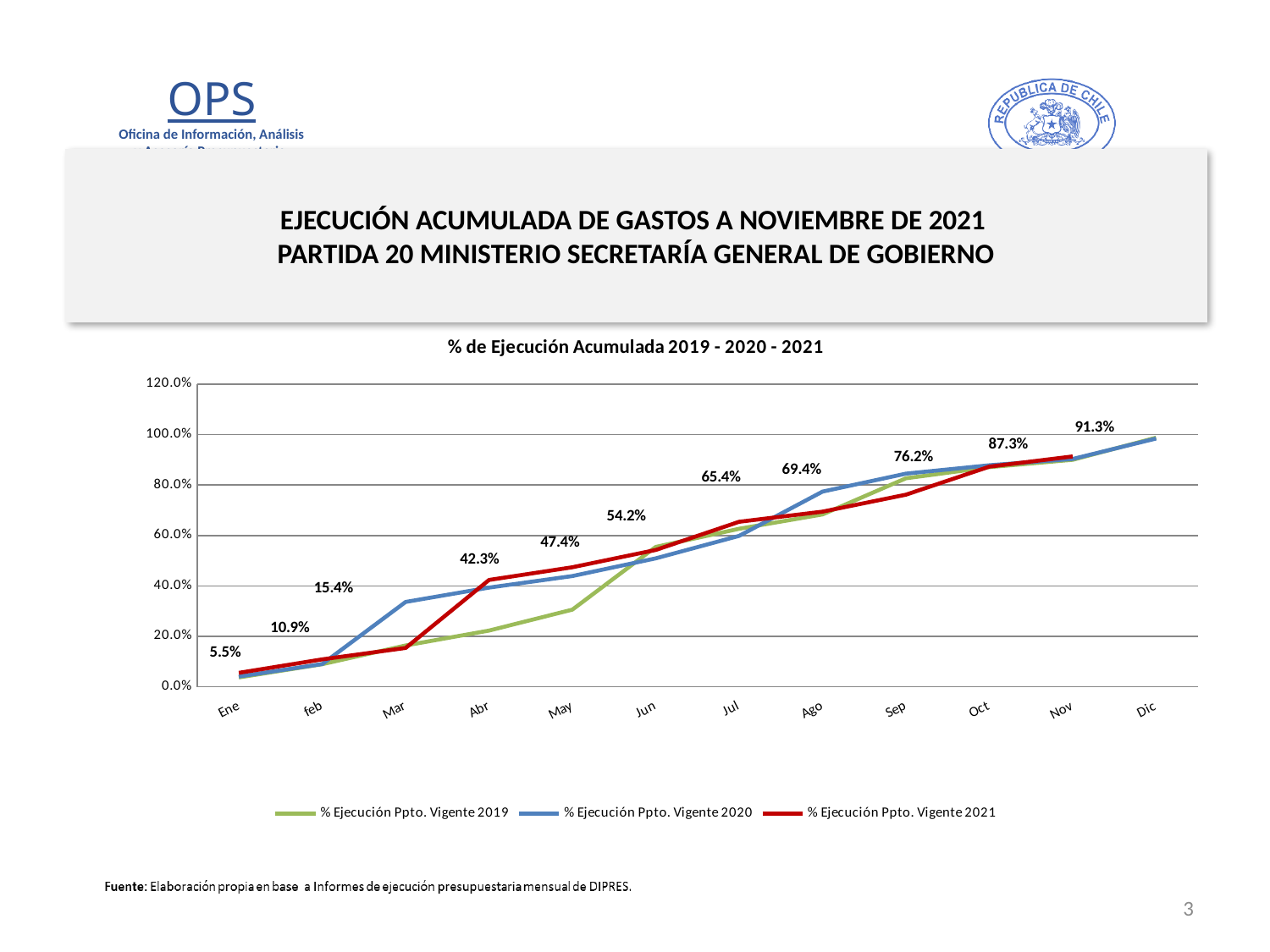
Is the value for % Ejecución Ppto. Vigente 2019 in May greater or less than 40.0%? less What is the value for % Ejecución Ppto. Vigente 2021 in Ene? 5.5% What is the difference between the 2021 values for Oct and Nov? 4.0% What is the title of the chart? % de Ejecución Acumulada 2019 - 2020 - 2021 Do the values for % Ejecución Ppto. Vigente 2021 rise or fall from Ene to Nov? Rise What type of chart is shown on the slide? Line chart What is the value for % Ejecución Ppto. Vigente 2021 in Nov? 91.3% How many months are shown on the x axis? 12 How many series does the legend list? 3 What is the value for % Ejecución Ppto. Vigente 2021 in Abr? 42.3% What is the difference between the 2021 values for Mar and Abr? 26.9% Is the value for % Ejecución Ppto. Vigente 2020 in Mar greater or less than 20.0%? greater